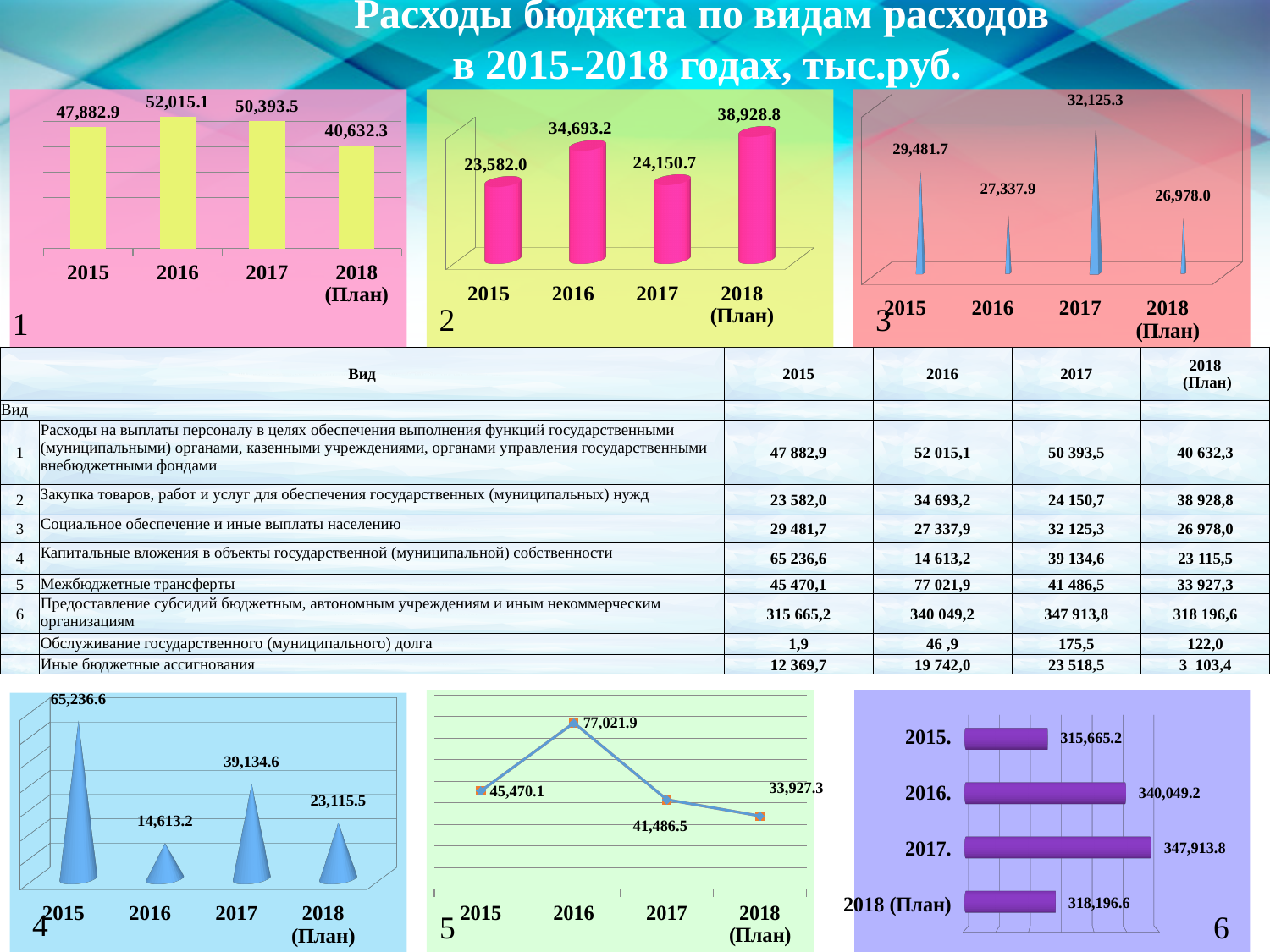
In chart 3 (top-right), what is the value for 2017? 32,125.3 How many categories (years) are shown in chart 4 (bottom-left)? 4 In chart 1 (top-left), what is the difference between the 2016 and 2015 values? 4,132.2 In chart 4 (bottom-left), which year has the lowest value? 2016 In chart 2 (top-middle), what is the difference between the 2018 (План) and 2015 values? 15,346.8 In chart 5 (bottom-middle), what is the value for 2016? 77,021.9 In chart 6 (bottom-right), which year has the highest value? 2017 In chart 3 (top-right), which is larger: the value for 2015 or the value for 2016? 2015 In chart 1 (top-left), what is the value for 2016? 52,015.1 In chart 2 (top-middle), which year has the highest value? 2018 (План) What kind of chart is chart 6 (bottom-right)? bar chart In chart 5 (bottom-middle), do the values rise or fall from 2016 to 2018 (План)? fall